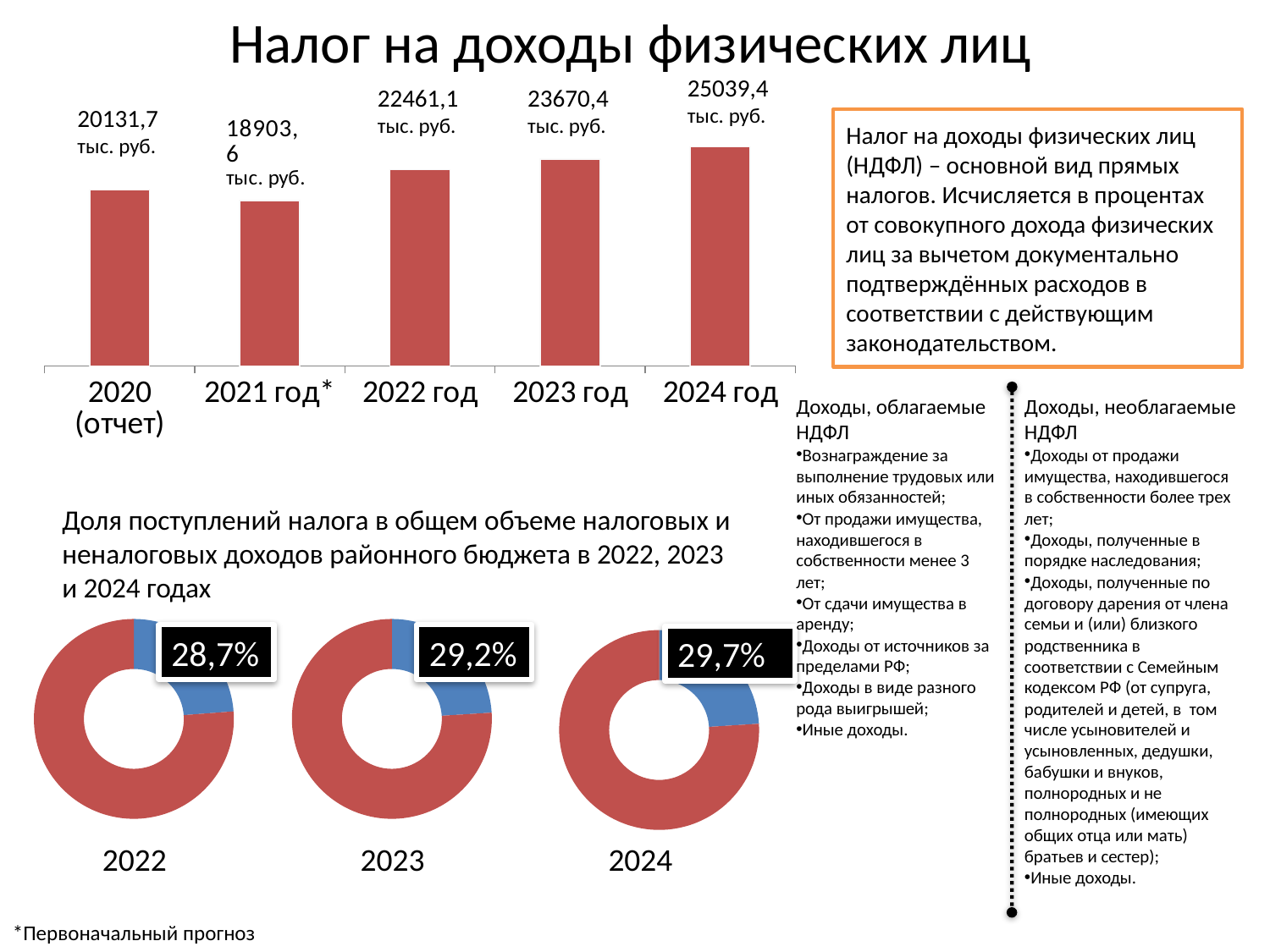
In the bar chart at the top, which category has the highest value? 2024 год In the bar chart at the top, what is the difference between the values for 2023 год and 2022 год? 1209,3 тыс. руб. In the bar chart at the top, what is the value for 2021 год*? 18903,6 тыс. руб. In the bar chart at the top, what is the value for 2022 год? 22461,1 тыс. руб. What kind of chart is shown at the top of the slide? Bar chart In the donut chart labelled 2023 at the bottom, what share is shown by the data label? 29,2% How many bars are in the bar chart at the top? 5 In the bar chart at the top, which is larger: the value for 2020 (отчет) or the value for 2021 год*? 2020 (отчет) In the bar chart at the top, do the values rise or fall from 2021 год* to 2024 год? Rise In the bar chart at the top, which category has the lowest value? 2021 год* In the bar chart at the top, what is the difference between the values for 2024 год and 2020 (отчет)? 4907,7 тыс. руб. Among the three donut charts at the bottom, which year shows the largest labelled share? 2024